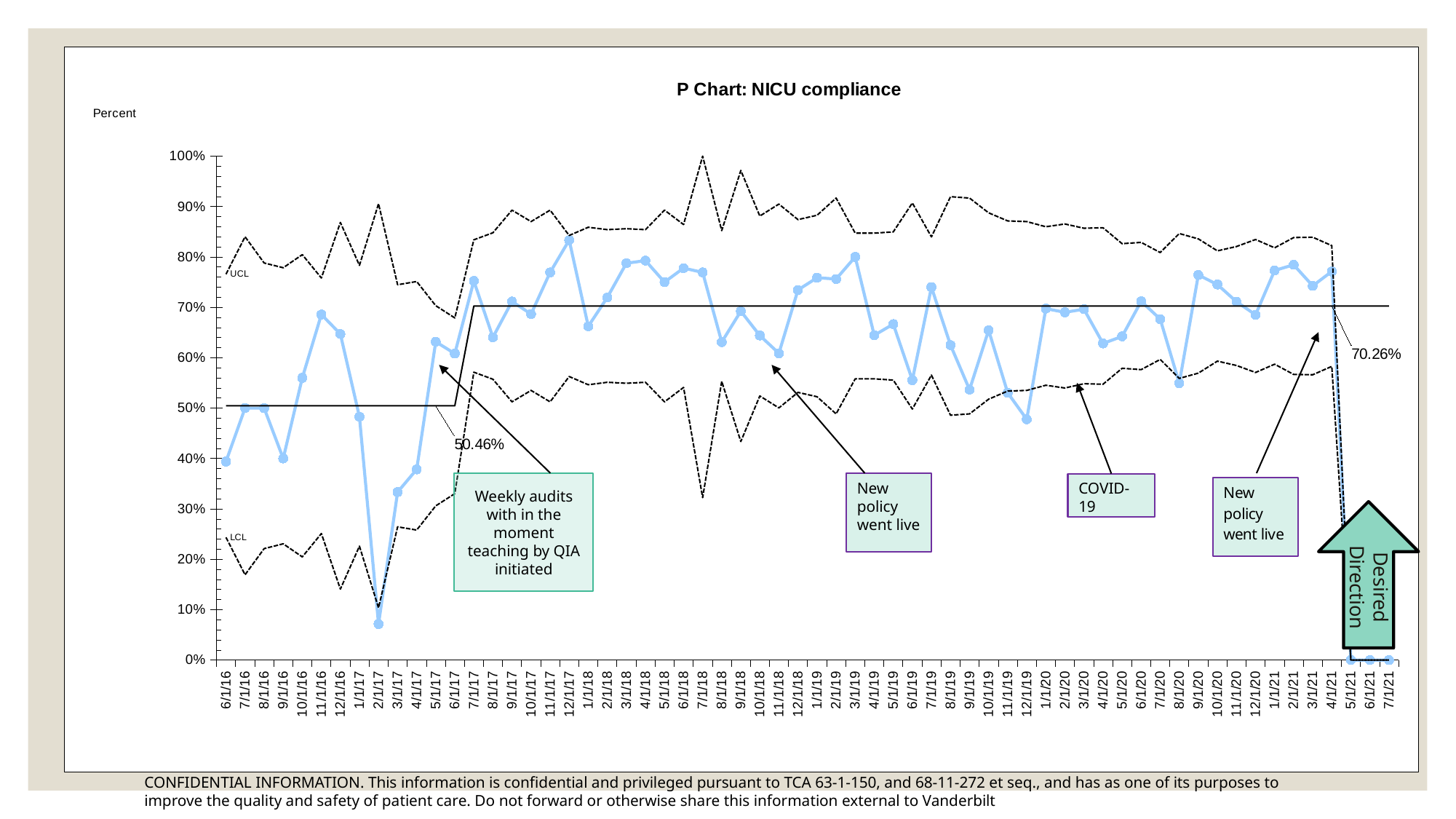
Is the value for 6/1/16 greater or less than 50%? less What value is printed for the center line in the period from 7/1/17 onward? 70.26% What label is shown in the annotation box pointing to the lower control limit around 2020? COVID-19 What is the title of the chart? P Chart: NICU compliance Is the value for 2/1/17 greater or less than 10%? less What kind of chart is shown on the slide? Line chart By how many percentage points does the later center line value (70.26%) exceed the earlier one (50.46%)? 19.80 percentage points Among the months before 2021, which month has the lowest plotted value? 2/1/17 Which is larger, the value for 12/1/17 or the value for 1/1/18? 12/1/17 What value is printed for the center line in the period before 7/1/17? 50.46% What value does the plotted line reach for 6/1/21? 0% Is the value for 12/1/17 greater or less than 80%? greater